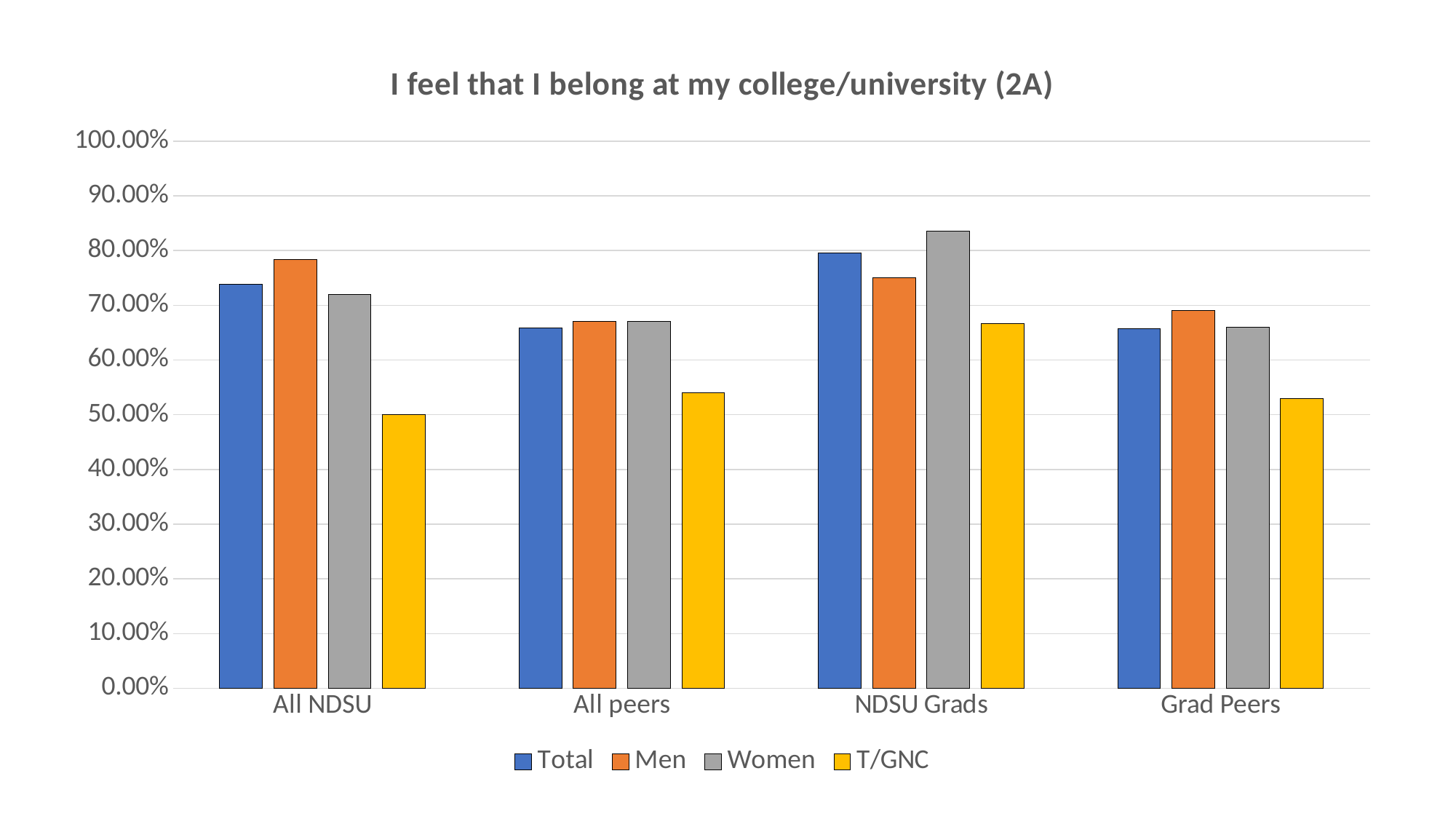
Which series has the lowest value in the All NDSU category? T/GNC Is the Men value for All NDSU greater or less than 70.00%? greater Which is larger, the Total value for All NDSU or the Total value for All peers? All NDSU What is the title of the chart? I feel that I belong at my college/university (2A) How many series does the legend list? 4 Is the Women value for NDSU Grads greater or less than 80.00%? greater Is the T/GNC value for Grad Peers greater or less than 60.00%? less Which category has the highest Women value? NDSU Grads What kind of chart is shown on the slide? bar chart How many categories are shown on the x axis? 4 Which category has the lowest T/GNC value? All NDSU Which series has the highest value in the NDSU Grads category? Women